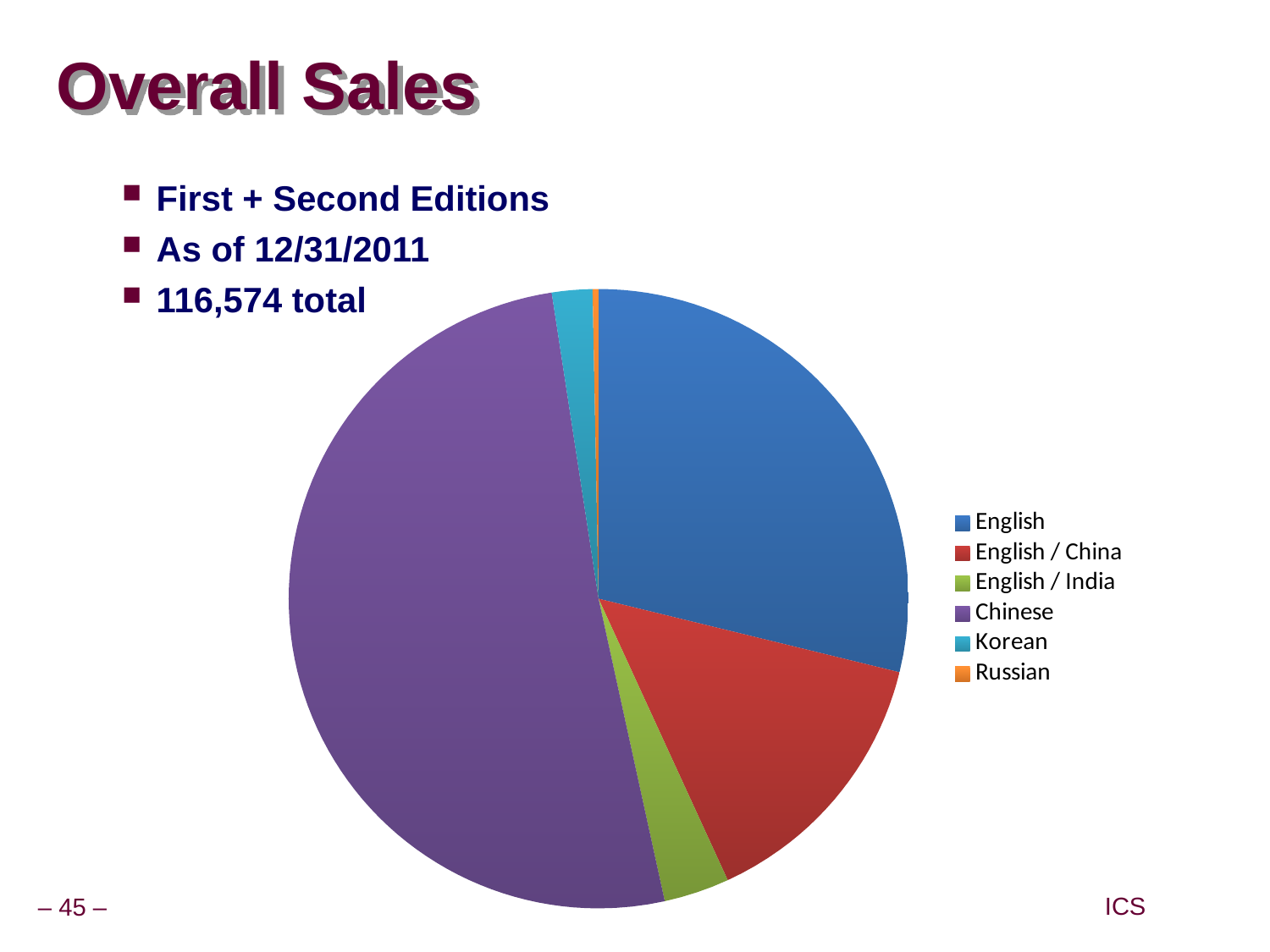
Which slice is larger, English / China or English / India? English / China Which slice is larger, English / China or Korean? English / China How many entries does the legend of the pie chart list? 6 How many slices does the pie chart have? 6 What kind of chart is shown on the slide? pie chart Which slice is larger, Korean or Russian? Korean Which category has the largest slice of the pie chart? Chinese What is the title of the slide containing the pie chart? Overall Sales What colour is the Chinese slice in the pie chart? purple Which category has the smallest slice of the pie chart? Russian